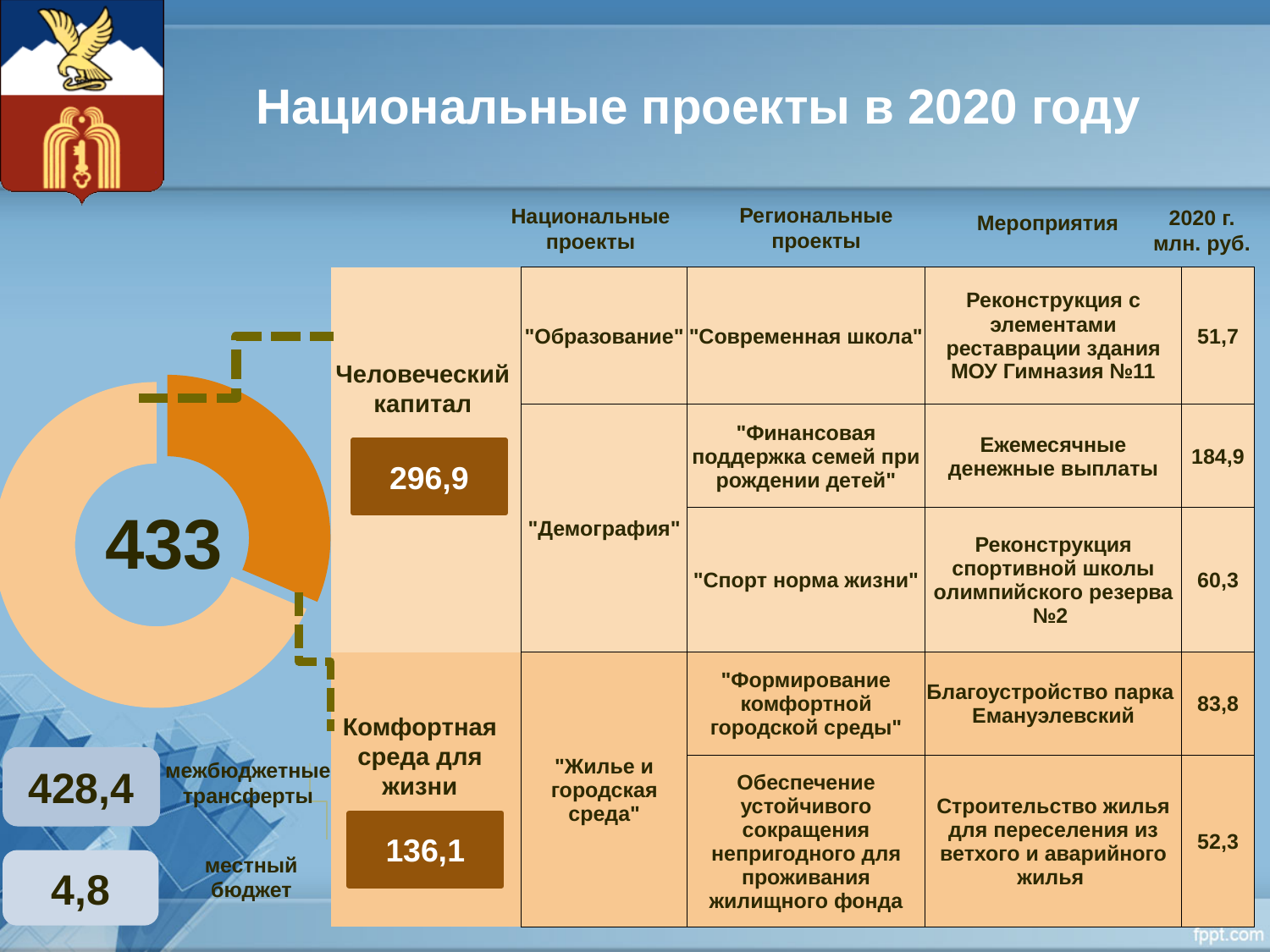
What is the title of the slide containing the donut chart? Национальные проекты в 2020 году Which is larger in the donut chart: "Человеческий капитал" or "Комфортная среда для жизни"? Человеческий капитал What number is printed in the centre of the donut chart? 433 What is the value for "Комфортная среда для жизни" in the donut chart? 136,1 What is the value for "Человеческий капитал" in the donut chart? 296,9 Which slice of the donut chart is the largest? Человеческий капитал Which slice of the donut chart is the smallest? Комфортная среда для жизни How many slices does the donut chart have? 2 What kind of chart is shown on the left of the slide? Donut (pie) chart What is the total of the two slices in the donut chart? 433 What is the difference between the values for "Человеческий капитал" and "Комфортная среда для жизни" in the donut chart? 160,8 In what units are the values of the donut chart given, according to the table header? млн. руб.